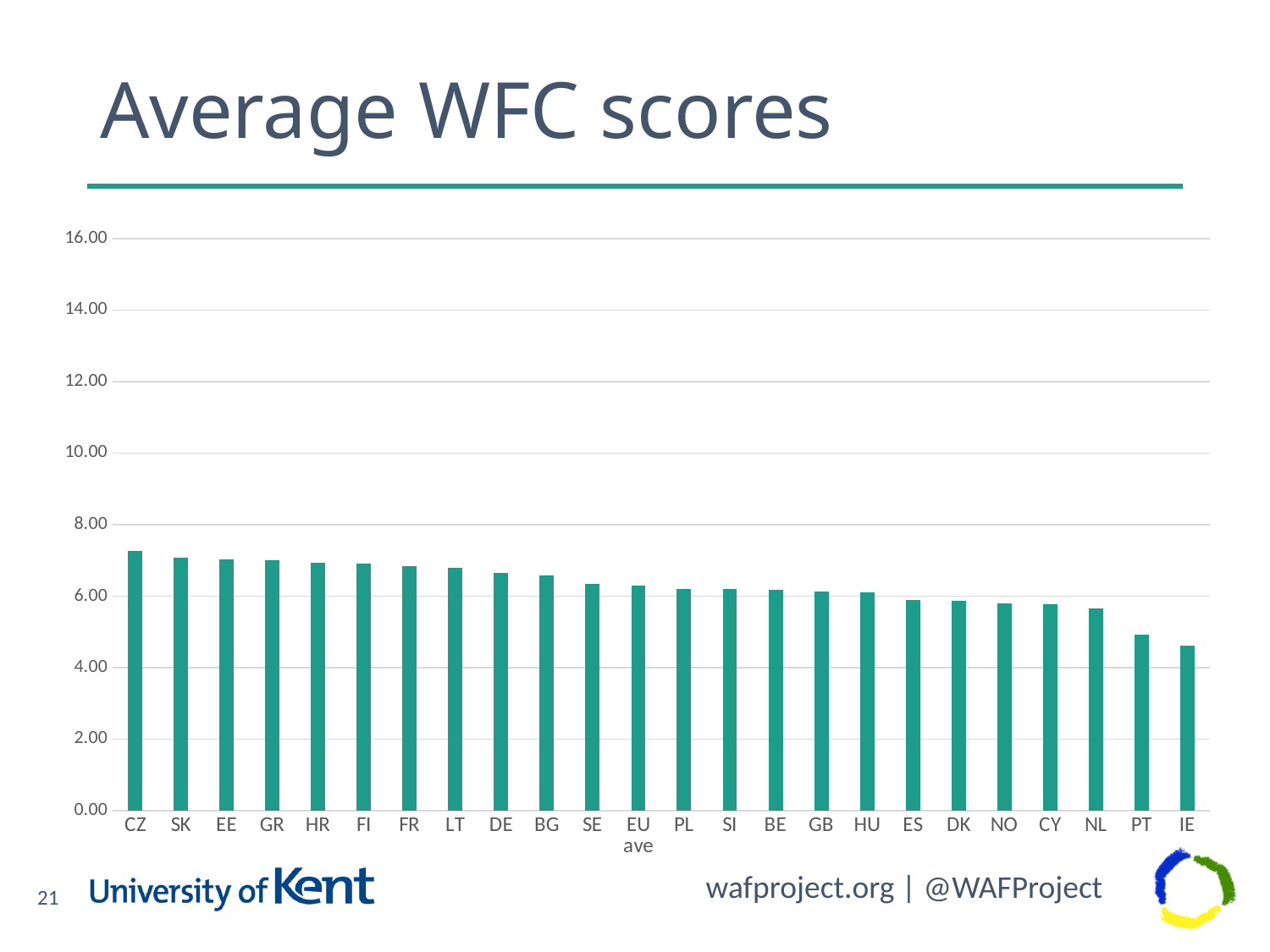
What kind of chart is shown on the slide? bar chart Which category has the lowest average WFC score? IE Is the value for CZ greater or less than 8.00? less Is the value for PT greater or less than 6.00? less Which is larger, the value for CZ or the value for IE? CZ Do the values rise or fall moving from left to right along the x axis? fall Which is larger, the value for PT or the value for NL? NL Is the value for SK greater or less than 6.00? greater What is the title of the chart? Average WFC scores How many categories are plotted along the x axis? 24 Which category has the highest average WFC score? CZ